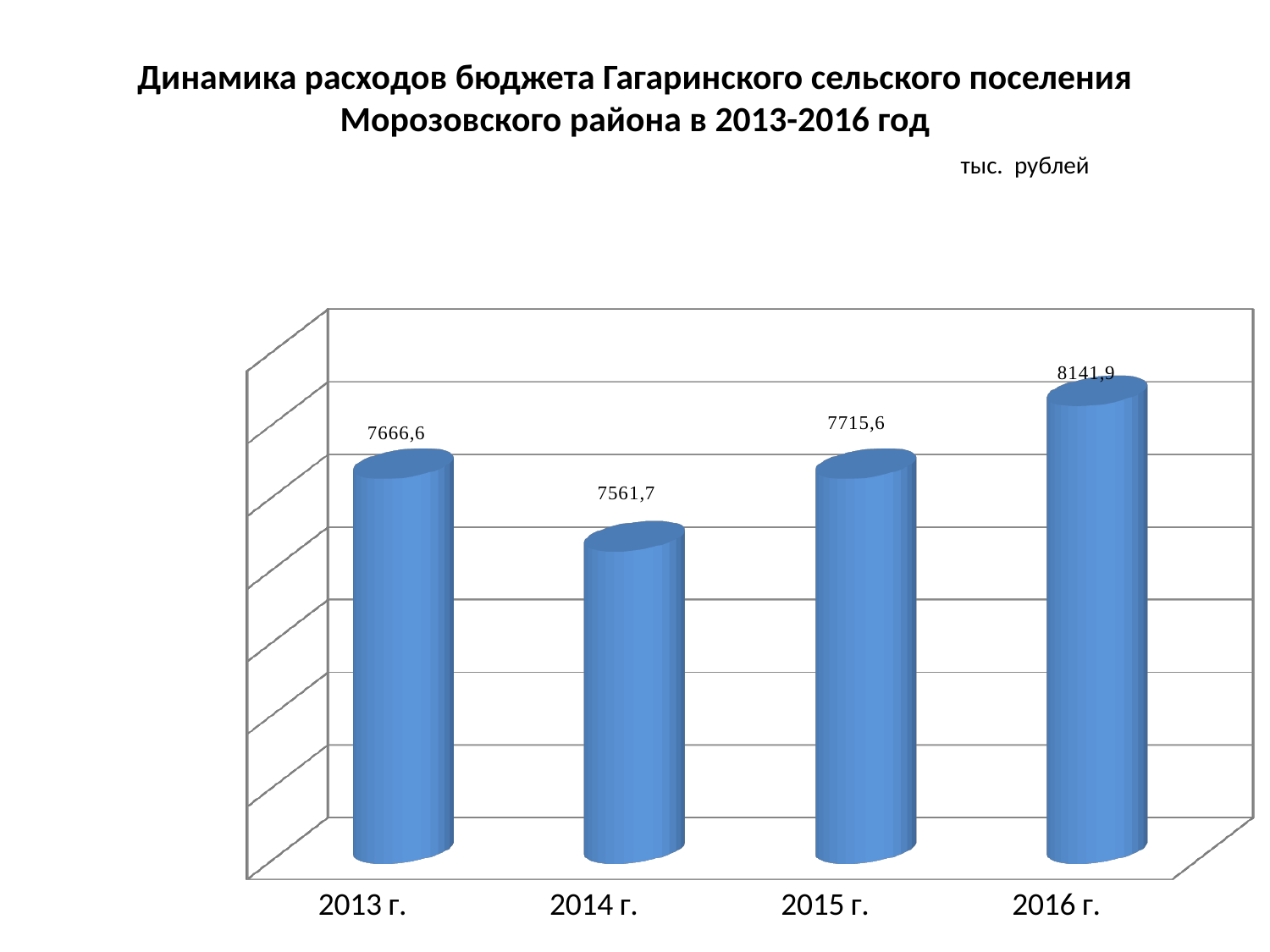
What is the value for 2013 г.? 7666,6 Which is larger, the value for 2013 г. or the value for 2015 г.? 2015 г. How many years are shown on the chart? 4 Which year has the highest value? 2016 г. What unit is stated for the values on the chart? тыс. рублей What is the value for 2014 г.? 7561,7 Which year has the lowest value? 2014 г. What is the value for 2016 г.? 8141,9 What is the value for 2015 г.? 7715,6 What kind of chart is this? Bar chart What is the difference between the values for 2016 г. and 2014 г.? 580,2 What is the difference between the values for 2013 г. and 2014 г.? 104,9